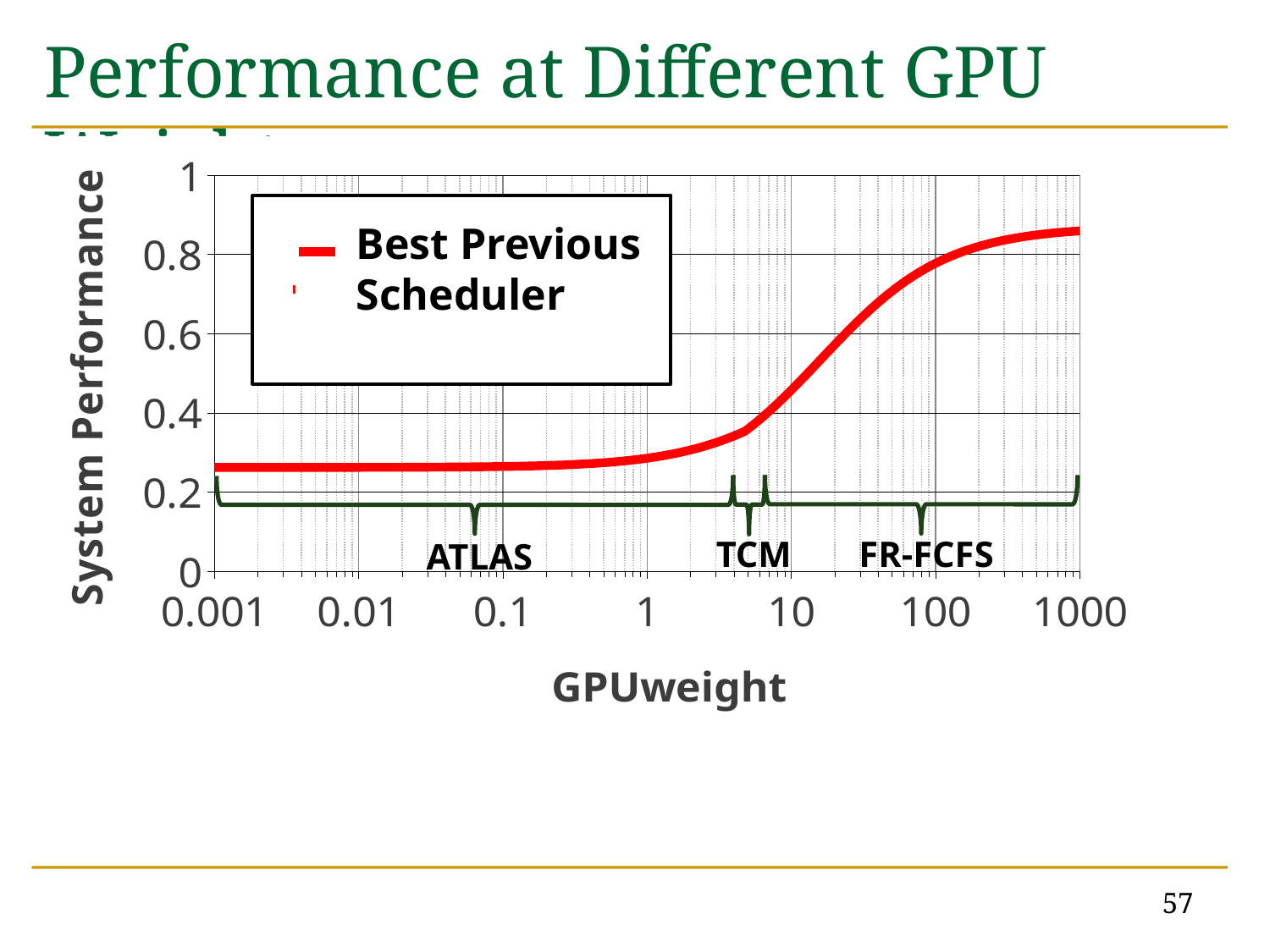
Is the System Performance of the Best Previous Scheduler at GPUweight 1 greater or less than 0.4? less What is the label of the y axis? System Performance At which GPUweight value on the x axis does the Best Previous Scheduler curve reach its highest System Performance? 1000 What is the smallest GPUweight value shown on the x axis? 0.001 What is the largest value shown on the y axis? 1 What kind of chart is shown on the slide? line chart Which is larger, the System Performance at GPUweight 1000 or at GPUweight 0.01? GPUweight 1000 Does the Best Previous Scheduler curve rise or fall as GPUweight increases? rise Is the System Performance of the Best Previous Scheduler at GPUweight 1000 greater or less than 0.8? greater Is the System Performance of the Best Previous Scheduler at GPUweight 0.001 greater or less than 0.4? less